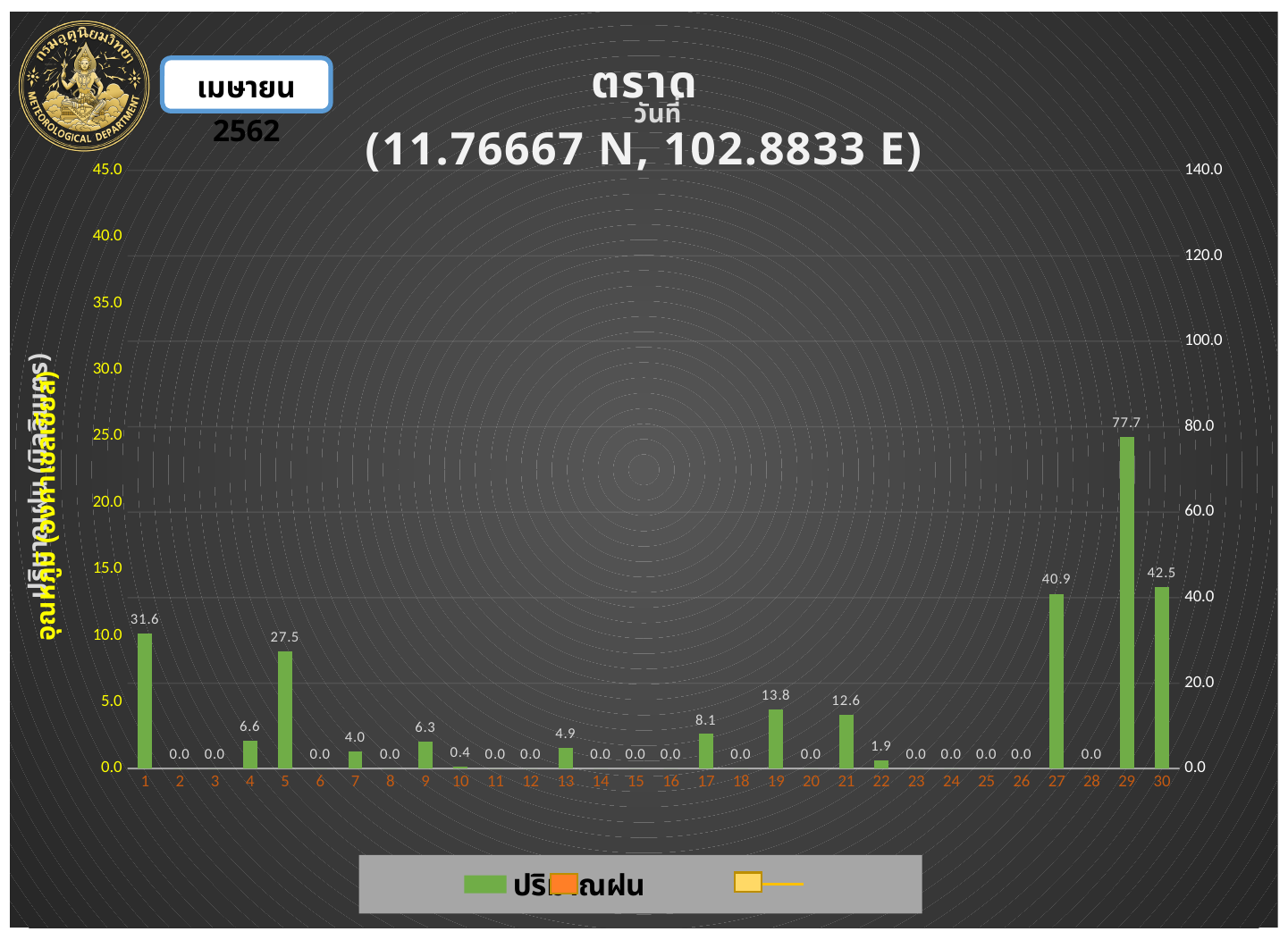
Which is larger, the rainfall value for day 4 or for day 9? day 4 What kind of chart is shown on the slide? bar chart What is the difference between the rainfall values for day 29 and day 30? 35.2 What is the rainfall value shown for day 29? 77.7 Which is larger, the rainfall value for day 21 or for day 19? day 19 How many days are shown on the x axis of the chart? 30 What is the rainfall value shown for day 10? 0.4 What is the rainfall value shown for day 1? 31.6 What is the rainfall value shown for day 19? 13.8 What is the difference between the rainfall values for day 27 and day 5? 13.4 Which day has the highest rainfall value? 29 What colour are the rainfall bars in the chart? green